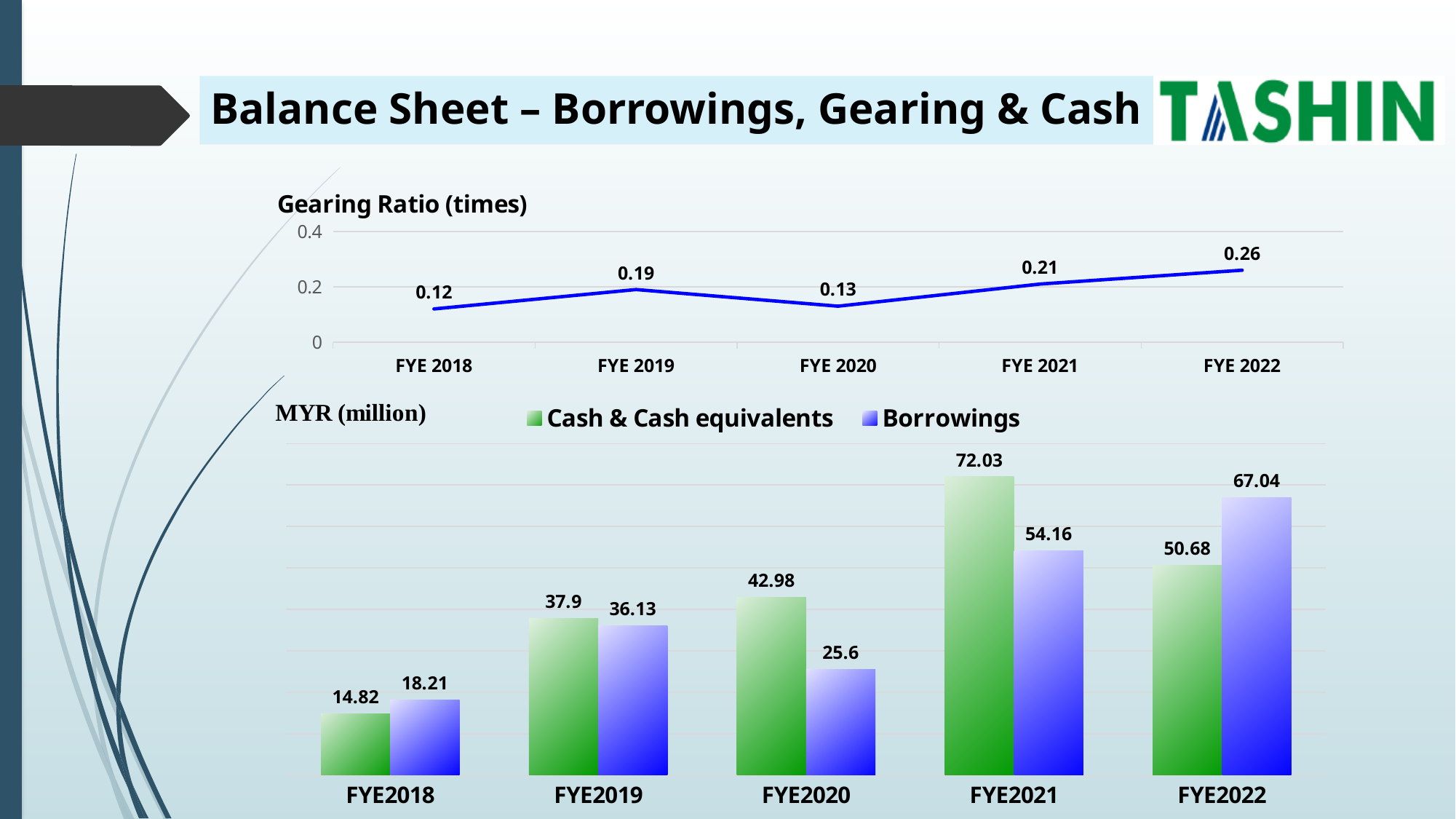
What kind of chart is the Gearing Ratio (times) chart? Line chart In the Gearing Ratio (times) chart, what is the difference between the FYE 2022 and FYE 2018 values? 0.14 In the bottom MYR (million) chart, what is the difference between Borrowings and Cash & Cash equivalents for FYE2022? 16.36 In the bottom MYR (million) chart, what is the value of Cash & Cash equivalents for FYE2021? 72.03 In the Gearing Ratio (times) chart, which year has the lowest gearing ratio? FYE 2018 In the bottom MYR (million) chart, which is larger for FYE2020: Cash & Cash equivalents or Borrowings? Cash & Cash equivalents In the Gearing Ratio (times) chart, how many years are plotted? 5 In the bottom MYR (million) chart, what is the value of Borrowings for FYE2020? 25.6 What kind of chart is the bottom MYR (million) chart? Bar chart How many series does the legend of the bottom MYR (million) chart list? 2 In the Gearing Ratio (times) chart, what is the value for FYE 2022? 0.26 In the bottom MYR (million) chart, which year has the highest Borrowings? FYE2022